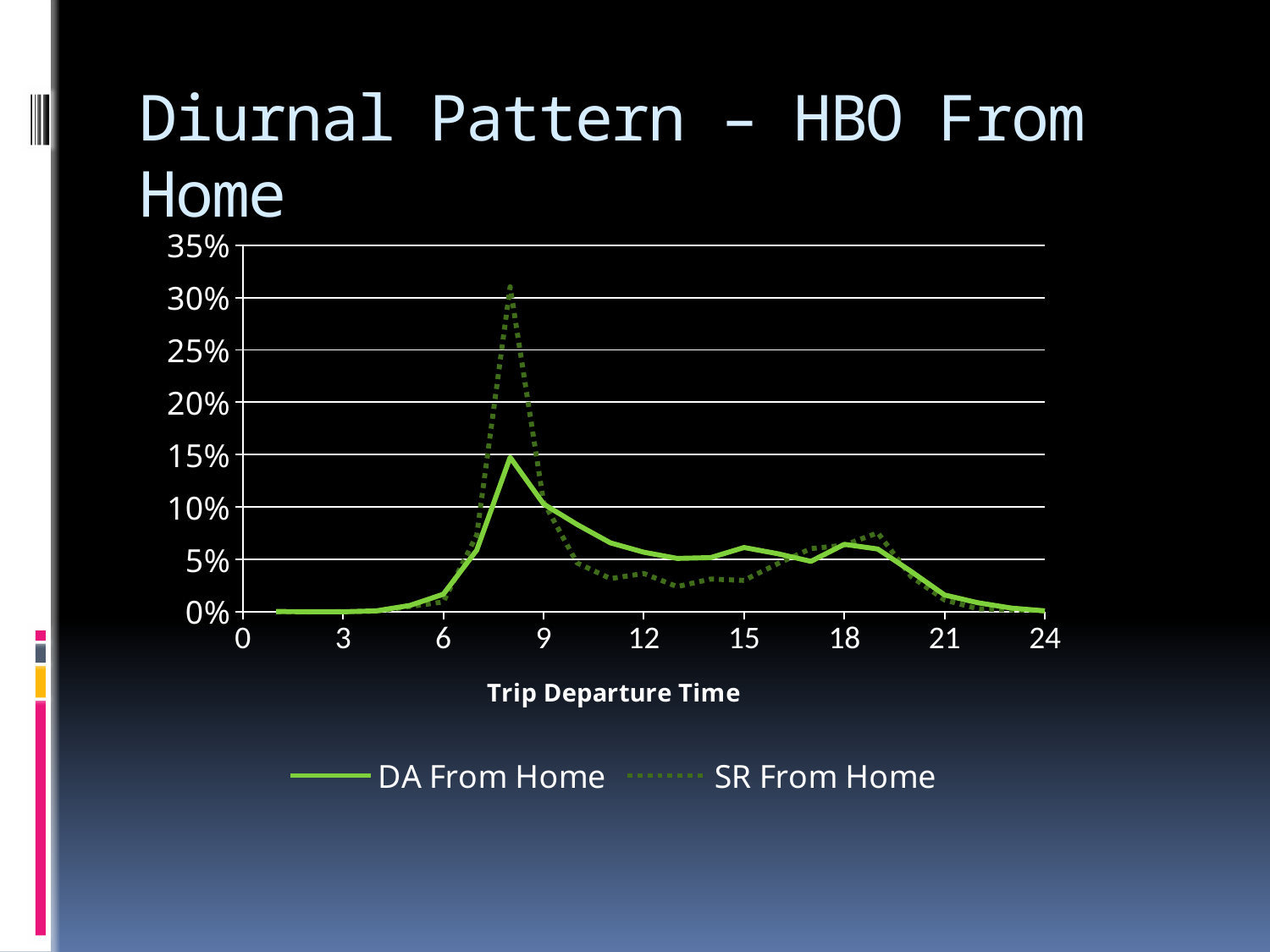
Is the value for DA From Home at departure time 8 greater or less than 10%? greater Is the value for SR From Home at departure time 13 greater or less than 5%? less At which trip departure time does the SR From Home series reach its highest value? 8 At departure time 11, which series has the higher value, DA From Home or SR From Home? DA From Home Between departure times 8 and 13, does the DA From Home series rise or fall? fall How many series does the legend list? 2 At departure time 8, which series has the higher value, DA From Home or SR From Home? SR From Home What kind of chart is shown on the slide? line chart Is the value for SR From Home at departure time 8 greater or less than 25%? greater What is the title of the x axis? Trip Departure Time At which trip departure time does the DA From Home series reach its highest value? 8 Which series is drawn with a dotted line? SR From Home